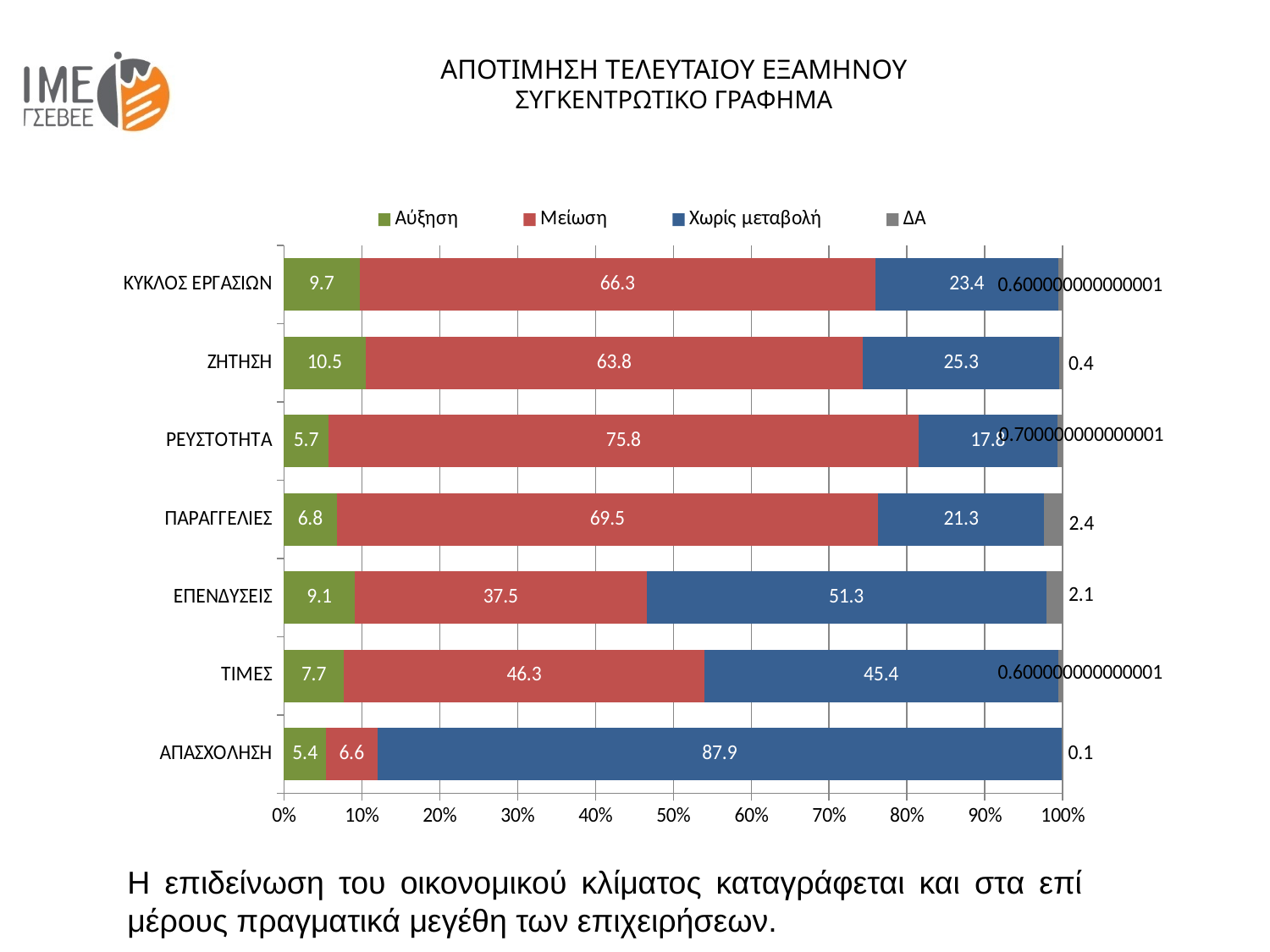
What is the difference between the Μείωση values for ΚΥΚΛΟΣ ΕΡΓΑΣΙΩΝ and ΖΗΤΗΣΗ? 2.5 How many series does the legend list? 4 Which category has the highest Μείωση value? ΡΕΥΣΤΟΤΗΤΑ How many categories are shown on the chart? 7 What is the value of Αύξηση for ΖΗΤΗΣΗ? 10.5 For ΕΠΕΝΔΥΣΕΙΣ, which is larger: Μείωση or Χωρίς μεταβολή? Χωρίς μεταβολή Which category has the highest Αύξηση value? ΖΗΤΗΣΗ What is the value of ΔΑ for ΠΑΡΑΓΓΕΛΙΕΣ? 2.4 What is the value of Χωρίς μεταβολή for ΑΠΑΣΧΟΛΗΣΗ? 87.9 What kind of chart is shown on the slide? Stacked bar chart Which category has the lowest Μείωση value? ΑΠΑΣΧΟΛΗΣΗ What is the value of Μείωση for ΡΕΥΣΤΟΤΗΤΑ? 75.8